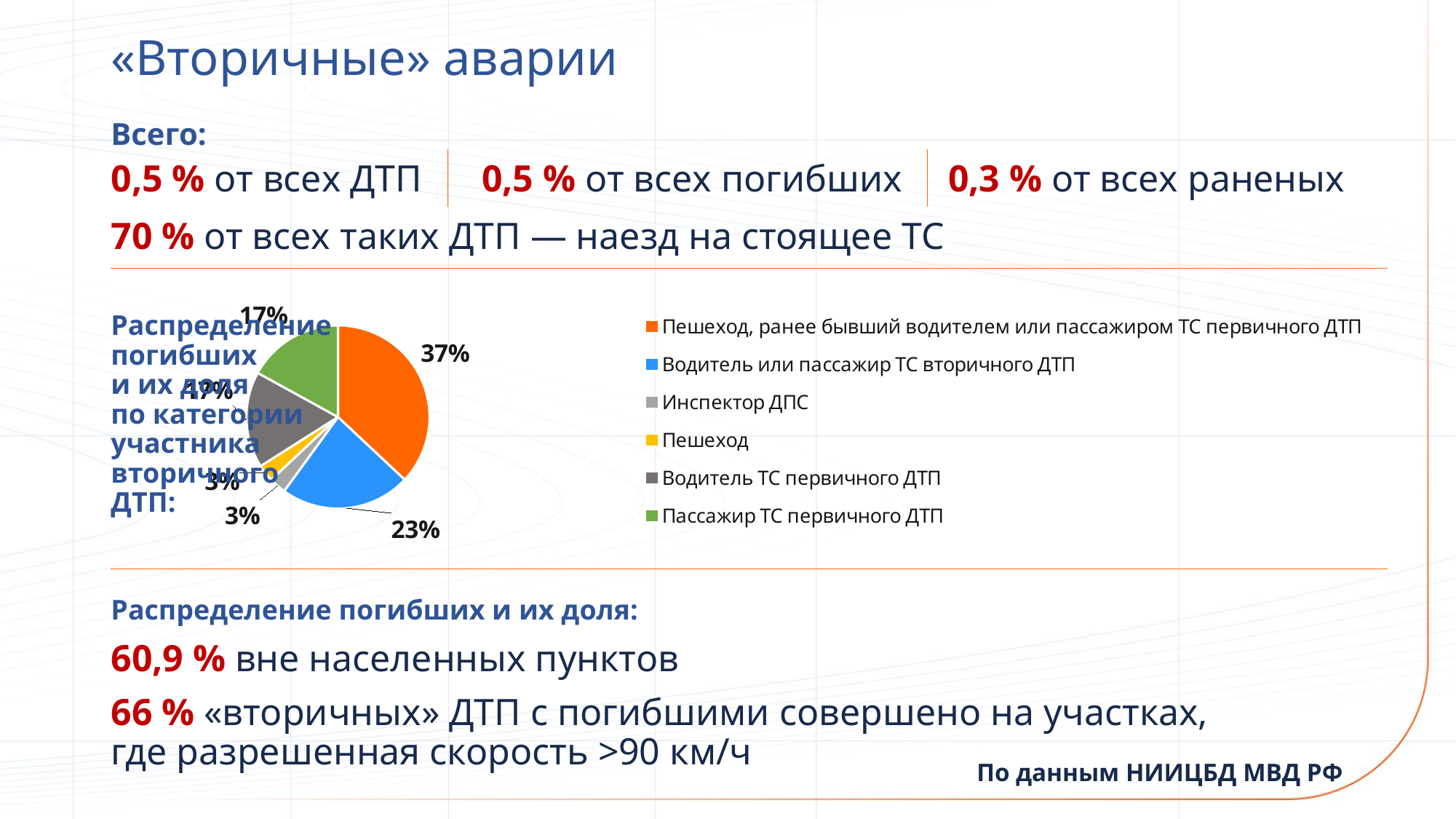
What kind of chart is shown on the slide? Pie chart How many categories does the pie chart legend list? 6 What share of the pie is labelled for "Инспектор ДПС"? 3% What is the difference in percentage points between the slice for "Пешеход, ранее бывший водителем или пассажиром ТС первичного ДТП" and the slice for "Водитель или пассажир ТС вторичного ДТП"? 14 percentage points What colour represents "Пассажир ТС первичного ДТП" in the pie chart? Green What share of the pie is labelled for "Пешеход, ранее бывший водителем или пассажиром ТС первичного ДТП"? 37% What share of the pie is labelled for "Пешеход"? 3% What share of the pie is labelled for "Пассажир ТС первичного ДТП"? 17% What share of the pie is labelled for "Водитель или пассажир ТС вторичного ДТП"? 23% What colour represents "Пешеход" in the pie chart legend? Yellow Which slice is larger: "Пассажир ТС первичного ДТП" or "Водитель или пассажир ТС вторичного ДТП"? Водитель или пассажир ТС вторичного ДТП Which category has the largest slice of the pie? Пешеход, ранее бывший водителем или пассажиром ТС первичного ДТП